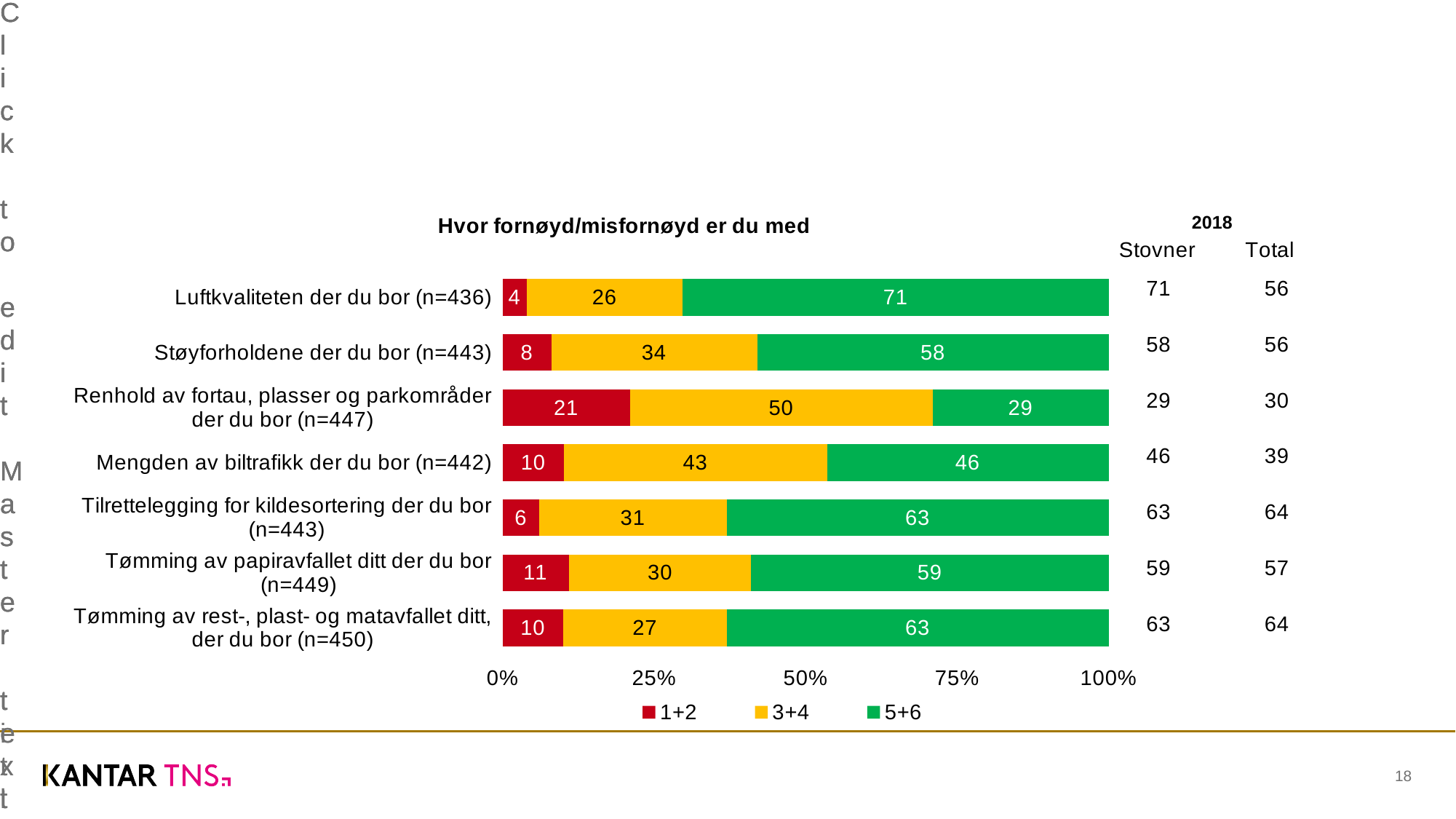
What is the 5+6 value for 'Luftkvaliteten der du bor (n=436)'? 71 What is the 1+2 value for 'Renhold av fortau, plasser og parkområder der du bor (n=447)'? 21 Which category has the highest 5+6 value? Luftkvaliteten der du bor (n=436) What kind of chart is shown on the slide? Stacked bar chart Which category has the lowest 5+6 value? Renhold av fortau, plasser og parkområder der du bor (n=447) Which category has the highest 1+2 value? Renhold av fortau, plasser og parkområder der du bor (n=447) Which has the larger 5+6 value: 'Støyforholdene der du bor (n=443)' or 'Mengden av biltrafikk der du bor (n=442)'? Støyforholdene der du bor (n=443) How many series does the chart legend list? 3 What is the difference between the 3+4 value for 'Renhold av fortau, plasser og parkområder der du bor (n=447)' and the 3+4 value for 'Luftkvaliteten der du bor (n=436)'? 24 What is the title of the chart? Hvor fornøyd/misfornøyd er du med How many categories (survey items) are plotted in the chart? 7 What is the 3+4 value for 'Mengden av biltrafikk der du bor (n=442)'? 43